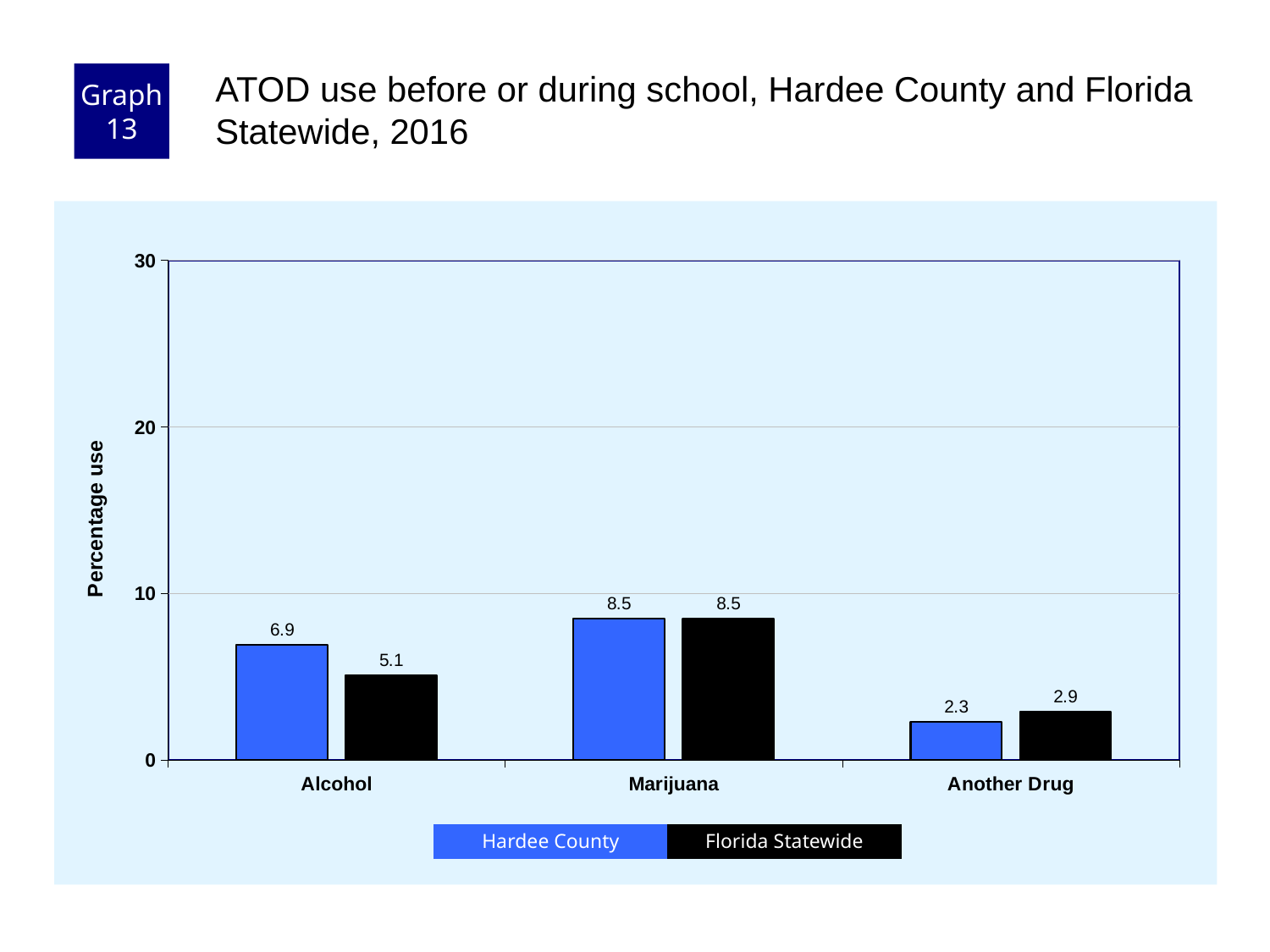
Is the Hardee County value for Marijuana greater or less than 10? less Which category has the lowest Florida Statewide value? Another Drug What is the Florida Statewide value for Another Drug? 2.9 What is the difference between the Hardee County and Florida Statewide values for Alcohol? 1.8 What is the Hardee County value for Alcohol? 6.9 How many categories are shown on the x axis? 3 What is the label of the y axis? Percentage use For Another Drug, which is larger: Hardee County or Florida Statewide? Florida Statewide How many series does the legend list? 2 What kind of chart is shown on the slide? bar chart What is the Florida Statewide value for Alcohol? 5.1 Which category has the highest Hardee County value? Marijuana